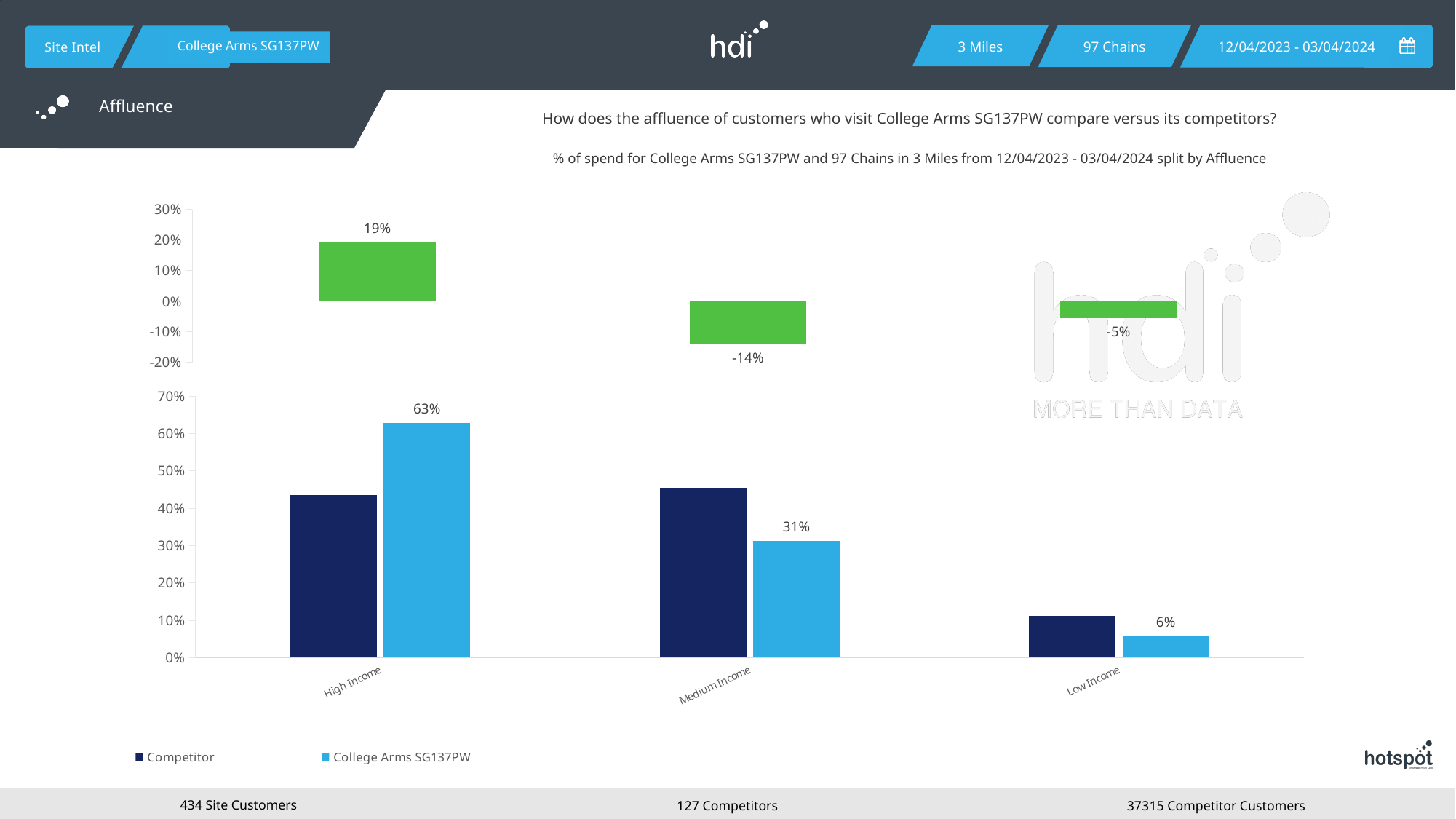
In the bottom chart, what is the value for College Arms SG137PW in the High Income category? 63% In the bottom chart, is the Competitor value for High Income greater or less than 40%? greater In the top chart, what is the value shown for the Medium Income category? -14% In the bottom chart, what is the value for College Arms SG137PW in the Low Income category? 6% In the bottom chart, which category has the highest value for College Arms SG137PW? High Income In the top chart, which category has the lowest value? Medium Income In the bottom chart, what is the value for College Arms SG137PW in the Medium Income category? 31% In the top chart, what is the value shown for the High Income category? 19% In the bottom chart, is the Competitor value for Low Income greater or less than 20%? less How many series does the legend of the bottom chart list? 2 In the bottom chart, what is the difference between the College Arms SG137PW values for High Income and Medium Income? 32% In the bottom chart, which is larger in the Medium Income category: Competitor or College Arms SG137PW? Competitor